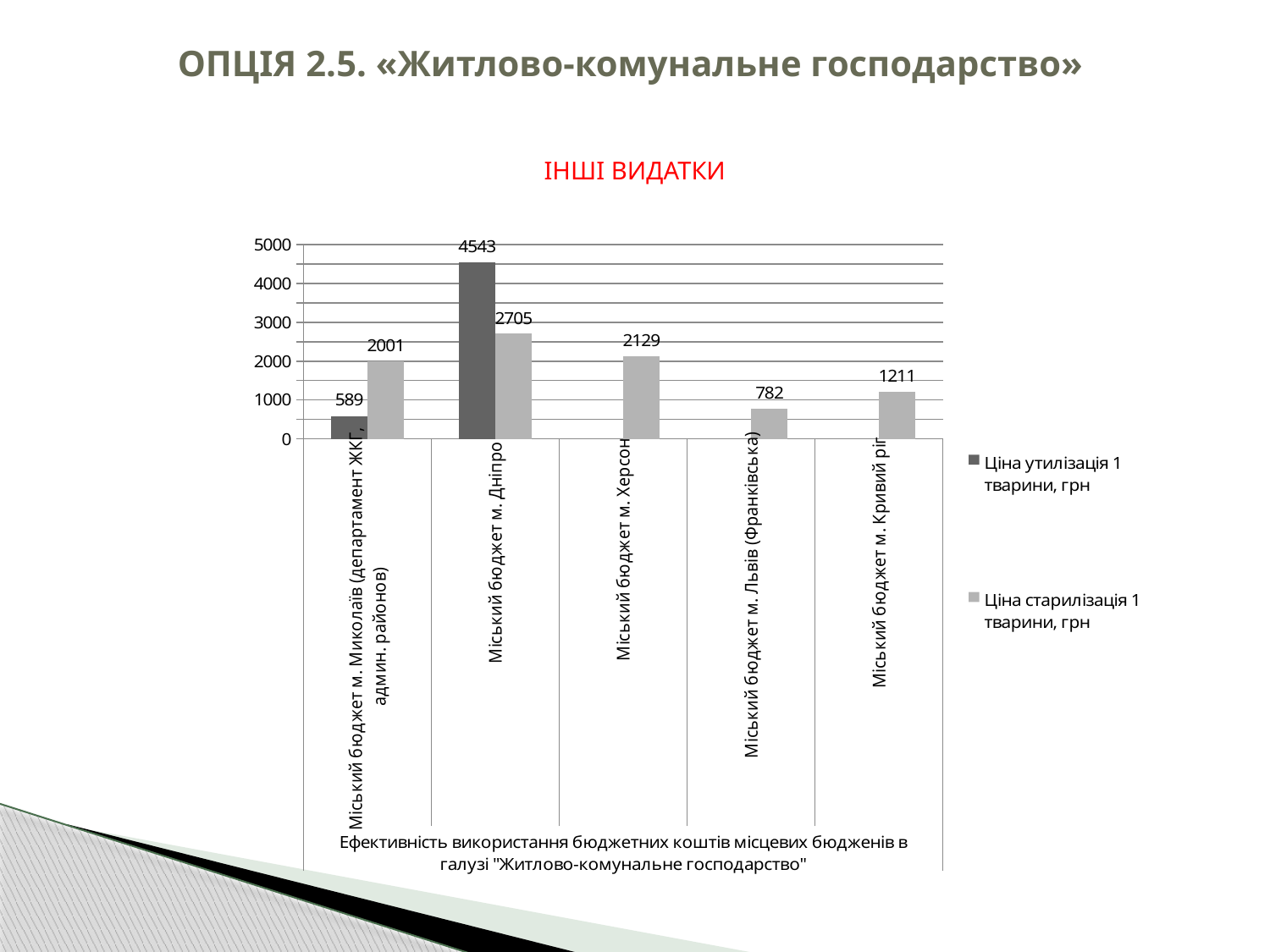
Which category has the highest value for 'Ціна старилізація 1 тварини, грн'? Міський бюджет м. Дніпро Which is larger for Міський бюджет м. Миколаїв: 'Ціна утилізація 1 тварини, грн' or 'Ціна старилізація 1 тварини, грн'? Ціна старилізація 1 тварини, грн How many series does the legend list? 2 What is the value of 'Ціна старилізація 1 тварини, грн' for Міський бюджет м. Херсон? 2129 What is the red subtitle above the chart? ІНШІ ВИДАТКИ What is the value of 'Ціна утилізація 1 тварини, грн' for Міський бюджет м. Дніпро? 4543 How many city budget categories are shown on the x axis? 5 What type of chart is shown on the slide? bar chart What is the value of 'Ціна старилізація 1 тварини, грн' for Міський бюджет м. Львів (Франківська)? 782 What is the difference between the 'Ціна старилізація 1 тварини, грн' values for Дніпро and Кривий ріг? 1494 What is the value of 'Ціна утилізація 1 тварини, грн' for Міський бюджет м. Миколаїв? 589 Which category has the lowest value for 'Ціна старилізація 1 тварини, грн'? Міський бюджет м. Львів (Франківська)